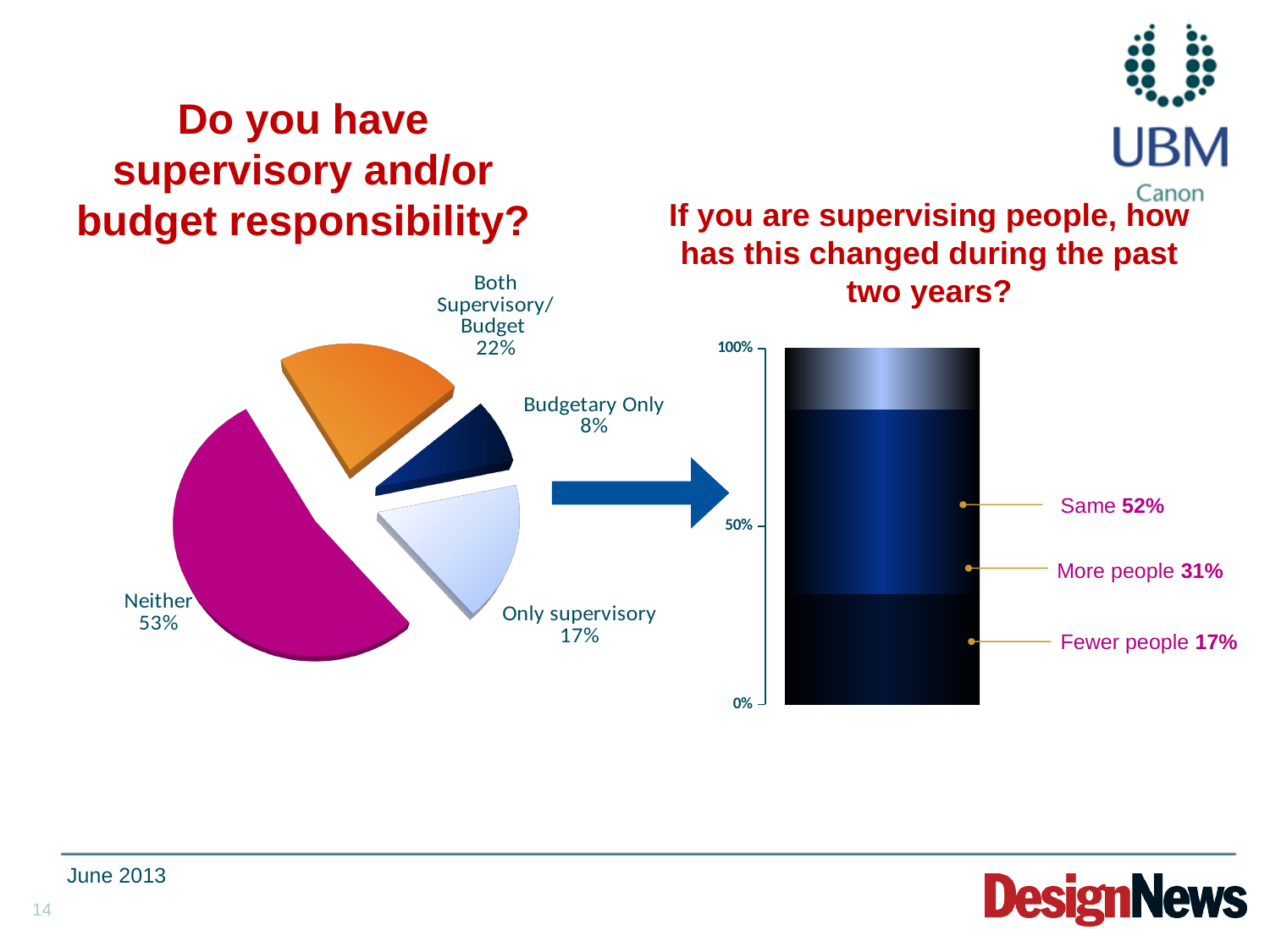
In the chart 'If you are supervising people, how has this changed during the past two years?', what is the total of the three segments in the stacked bar? 100% In the chart 'If you are supervising people, how has this changed during the past two years?', which is larger: More people or Fewer people? More people In the pie chart 'Do you have supervisory and/or budget responsibility?', what percentage of respondents answered Neither? 53% In the pie chart 'Do you have supervisory and/or budget responsibility?', which category has the smallest slice? Budgetary Only In the pie chart 'Do you have supervisory and/or budget responsibility?', how many slices are there? 4 In the pie chart 'Do you have supervisory and/or budget responsibility?', which category has the largest slice? Neither What type of chart is used on the left side of the slide for 'Do you have supervisory and/or budget responsibility?'? Pie chart In the chart 'If you are supervising people, how has this changed during the past two years?', what percentage answered Same? 52% In the chart 'If you are supervising people, how has this changed during the past two years?', what percentage answered Fewer people? 17% In the pie chart 'Do you have supervisory and/or budget responsibility?', what share is labelled Both Supervisory/Budget? 22% In the pie chart 'Do you have supervisory and/or budget responsibility?', how many percentage points larger is Only supervisory than Budgetary Only? 9 In the pie chart 'Do you have supervisory and/or budget responsibility?', what percentage is Budgetary Only? 8%